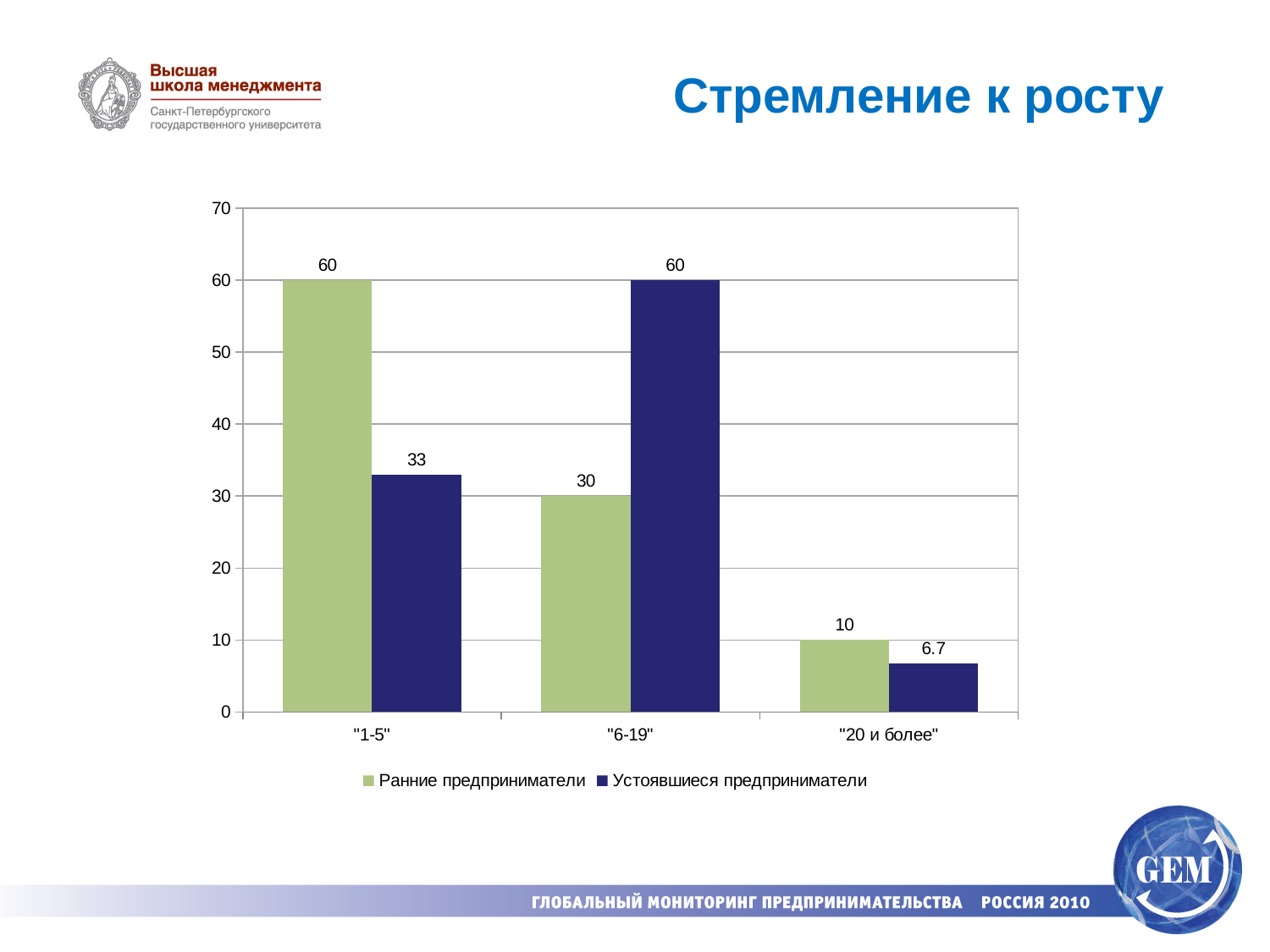
How many series does the legend list? 2 Which category has the lowest value for Ранние предприниматели? "20 и более" In the "1-5" category, which series has the larger value? Ранние предприниматели What is the value for Устоявшиеся предприниматели in the "1-5" category? 33 Which category has the highest value for Устоявшиеся предприниматели? "6-19" What kind of chart is shown on the slide? Bar chart What is the value for Устоявшиеся предприниматели in the "20 и более" category? 6.7 How many categories are shown on the x axis? 3 Do the values for Ранние предприниматели rise or fall across the categories from left to right? Fall What is the value for Ранние предприниматели in the "1-5" category? 60 What is the difference between Устоявшиеся предприниматели and Ранние предприниматели in the "6-19" category? 30 What is the title of the slide? Стремление к росту